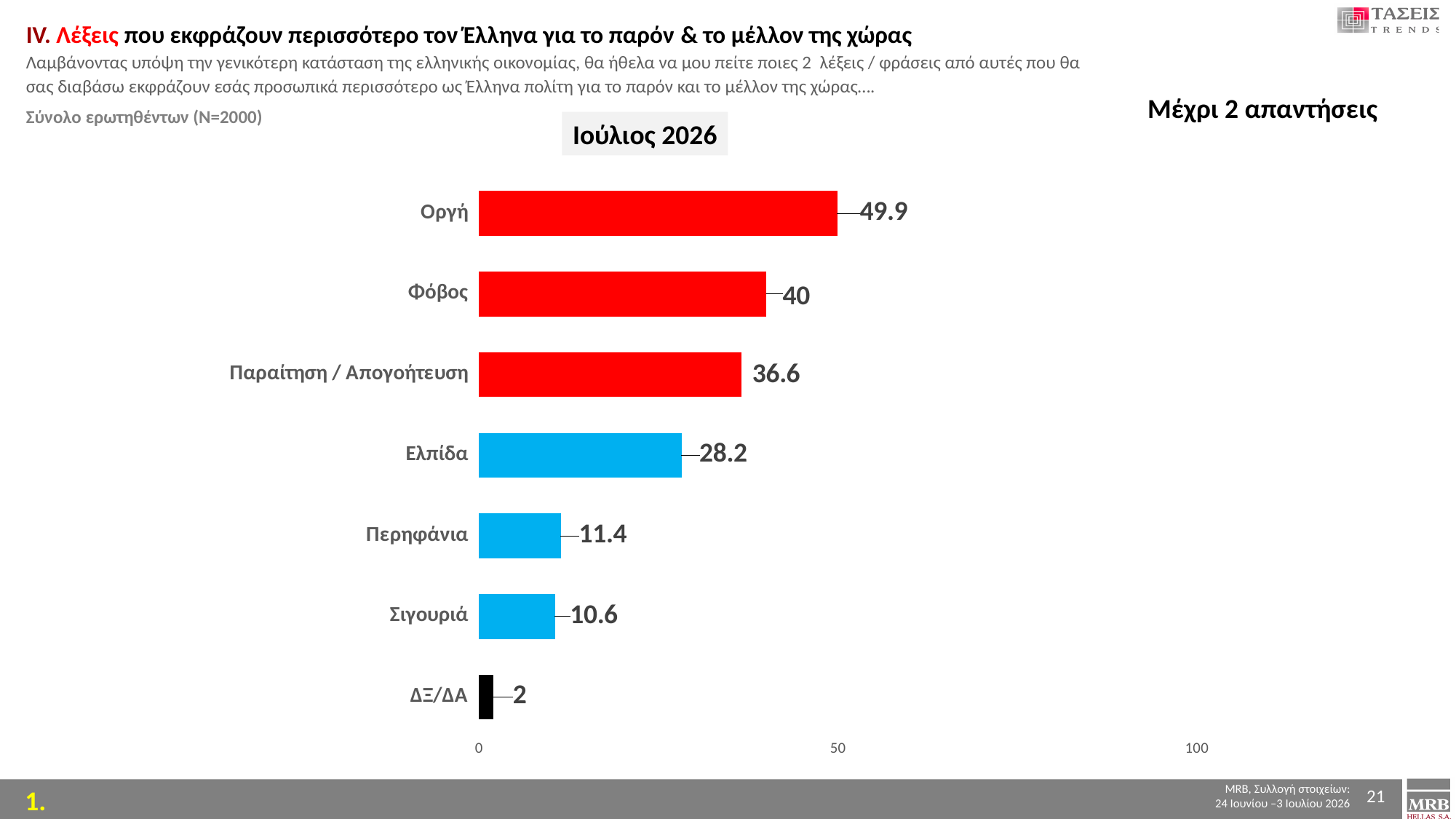
What is the title shown above the chart? Ιούλιος 2026 Which is larger, the value for Περηφάνια or the value for Σιγουριά? Περηφάνια What is the value for Ελπίδα? 28.2 What is the value for Οργή? 49.9 Is the value for Φόβος greater or less than 50? less What is the value for Σιγουριά? 10.6 What is the difference between the values for Παραίτηση / Απογοήτευση and Ελπίδα? 8.4 How many categories are shown in the chart? 7 What kind of chart is shown on the slide? bar chart Which category has the lowest value? ΔΞ/ΔΑ What is the difference between the values for Οργή and Φόβος? 9.9 Which category has the highest value? Οργή